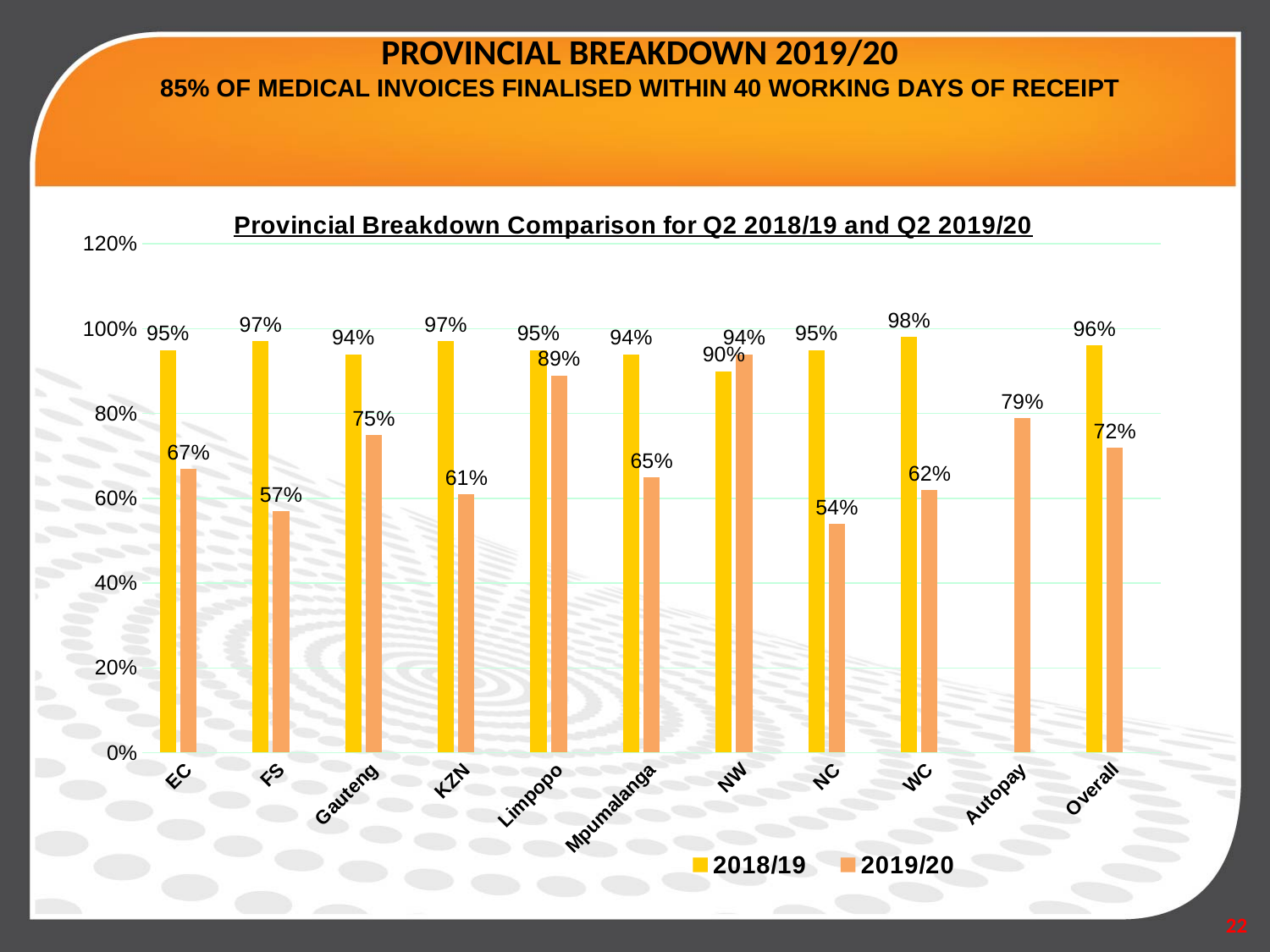
Which category has the lowest 2018/19 value? NW Which category has the lowest 2019/20 value? NC How many series does the legend list? 2 What is the title of the chart? Provincial Breakdown Comparison for Q2 2018/19 and Q2 2019/20 What is the difference between the 2018/19 and 2019/20 values for EC? 28 percentage points What is the 2018/19 value for WC? 98% Which is larger for Limpopo: the 2018/19 value or the 2019/20 value? 2018/19 How many categories are shown on the x axis? 11 Which category has the highest 2019/20 value? NW What is the 2019/20 value for Autopay? 79% What kind of chart is shown on the slide? Bar chart What is the 2019/20 value for Gauteng? 75%